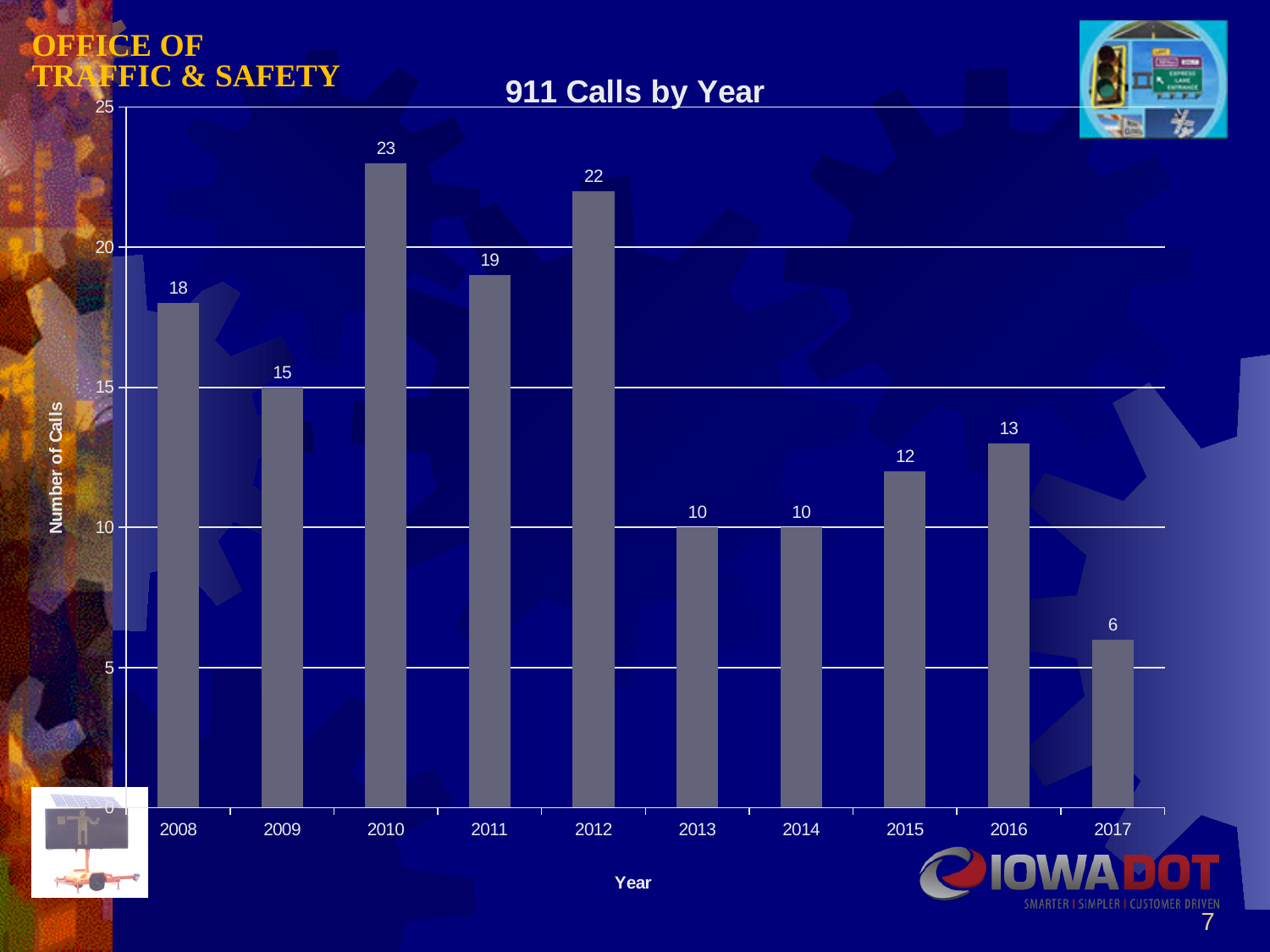
What is the number of 911 calls in 2015? 12 What is the title of the chart? 911 Calls by Year What is the number of 911 calls in 2017? 6 What is the number of 911 calls in 2010? 23 Which year had more 911 calls, 2011 or 2016? 2011 Which year has the lowest number of 911 calls? 2017 Is the value for 2012 greater or less than 20? greater What is the difference in 911 calls between 2008 and 2009? 3 Which year has the highest number of 911 calls? 2010 What kind of chart is shown on the slide? bar chart What is the difference in 911 calls between 2010 and 2017? 17 How many years are shown on the x axis? 10